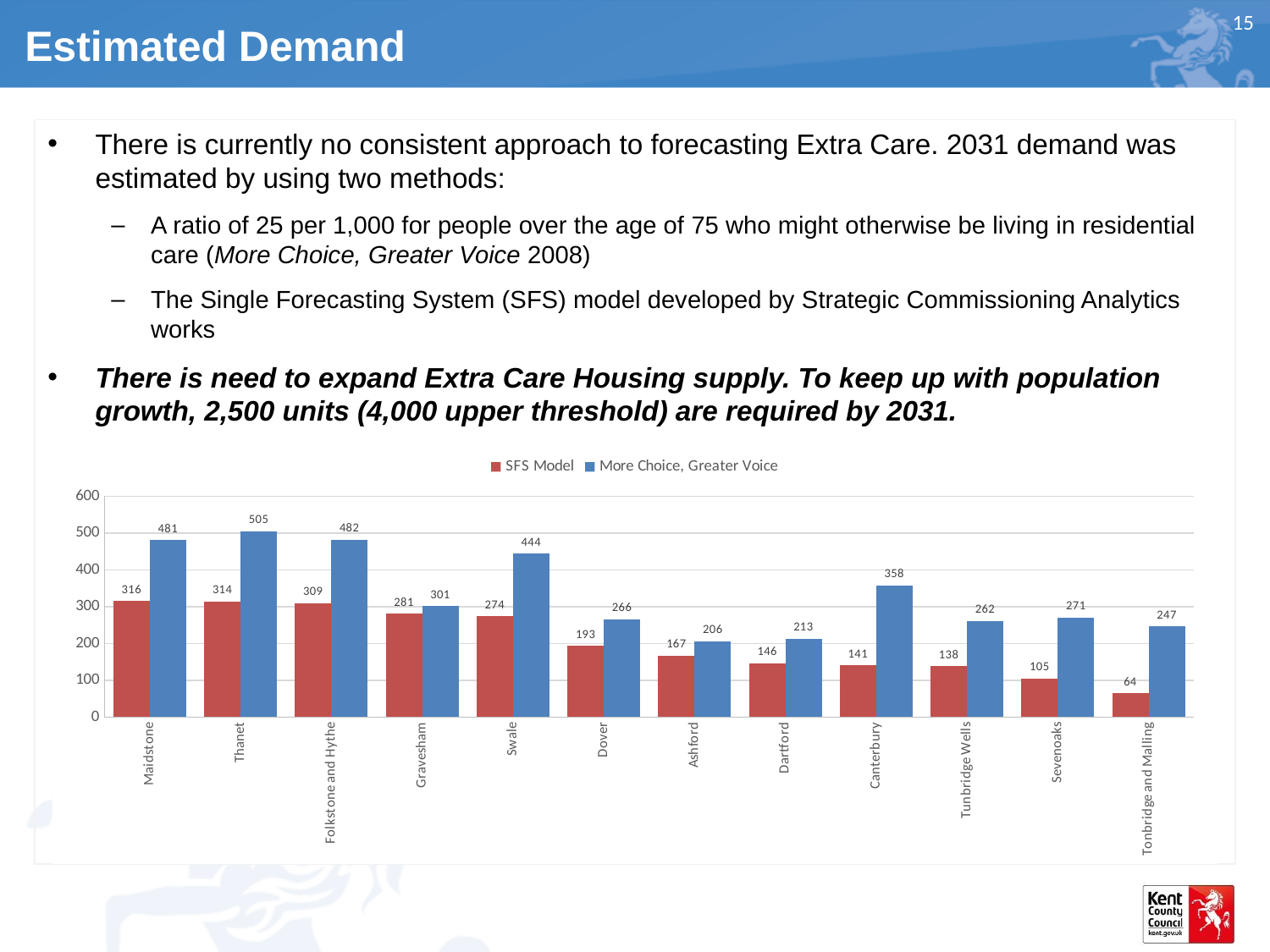
How many series does the legend list? 2 What is the More Choice, Greater Voice value for Canterbury? 358 Which category has the lowest SFS Model value? Tonbridge and Malling Is the SFS Model value for Sevenoaks greater or less than 200? less Do the SFS Model values generally rise or fall from left to right along the x axis? fall What is the SFS Model value for Maidstone? 316 Which category has the highest More Choice, Greater Voice value? Thanet What kind of chart is shown on the slide? bar chart What is the difference between the More Choice, Greater Voice value and the SFS Model value for Swale? 170 How many categories are shown on the x axis? 12 Which is larger for Dover: the SFS Model value or the More Choice, Greater Voice value? More Choice, Greater Voice What colour are the SFS Model bars? red